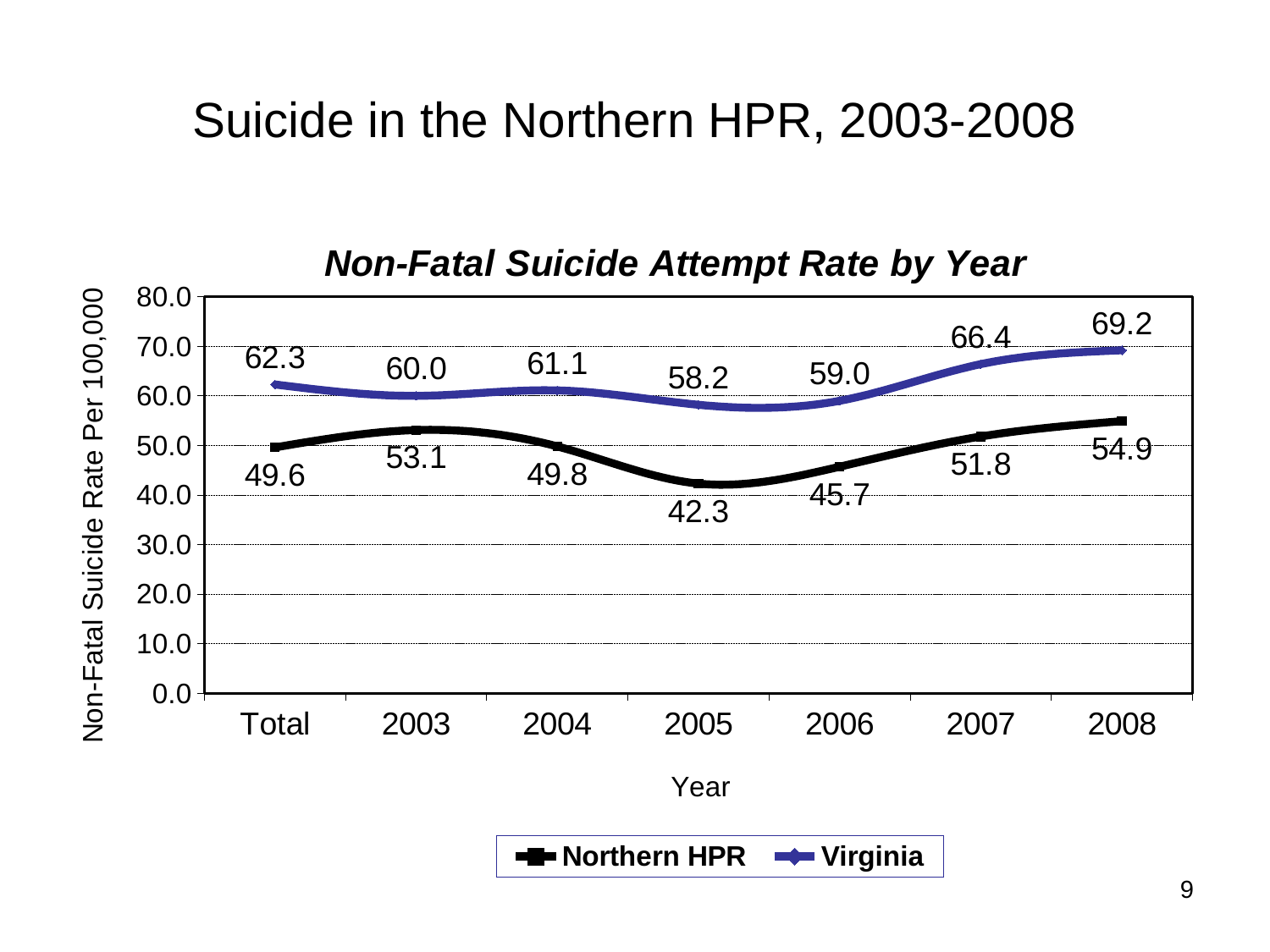
How many series does the legend list? 2 In which year is the Northern HPR rate lowest? 2005 What is the Northern HPR value for the Total category? 49.6 What kind of chart is shown on the slide? Line chart In which year is the Virginia rate highest? 2008 What is the Non-Fatal Suicide Attempt Rate for Northern HPR in 2005? 42.3 What is the title of the chart? Non-Fatal Suicide Attempt Rate by Year Does the Virginia rate rise or fall from 2006 to 2008? Rise How many categories are shown on the x axis? 7 Which series has the higher rate in 2007, Northern HPR or Virginia? Virginia What is the Non-Fatal Suicide Attempt Rate for Virginia in 2008? 69.2 What is the difference between the Virginia and Northern HPR rates in 2006? 13.3